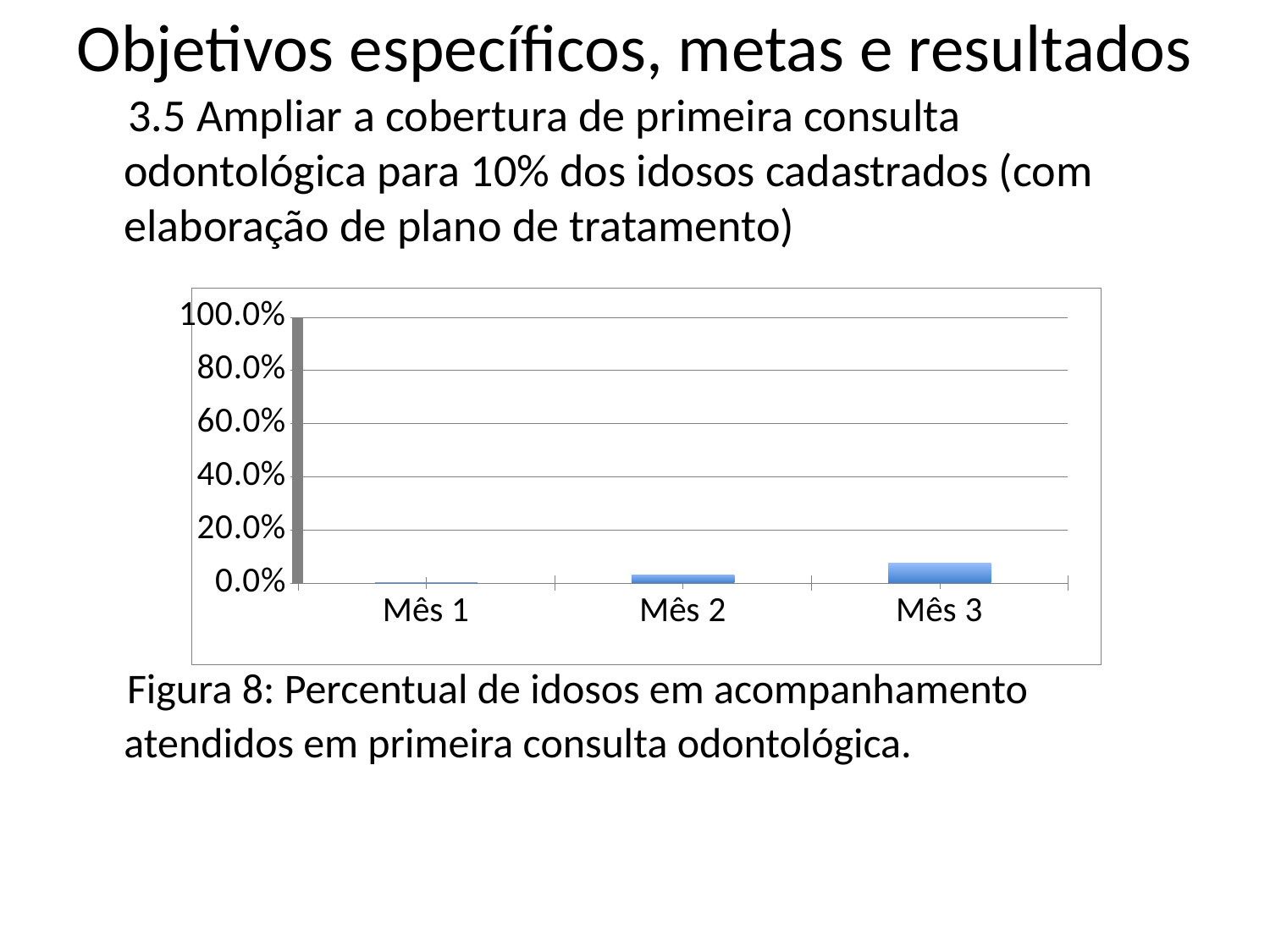
Is the value for Mês 2 greater or less than 20.0%? less How many labeled months are shown on the x axis of the chart? 3 What figure number is given in the caption below the chart? Figura 8 Which is larger, the value for Mês 2 or the value for Mês 3? Mês 3 Do the values rise or fall from Mês 1 to Mês 3? rise Which labeled month has the highest bar in the chart? Mês 3 Which labeled month has the lowest bar in the chart? Mês 1 What kind of chart is shown on the slide? bar chart Is the value for Mês 1 greater or less than 20.0%? less What is the highest tick value shown on the y axis of the chart? 100.0% Is the value for Mês 3 greater or less than 20.0%? less